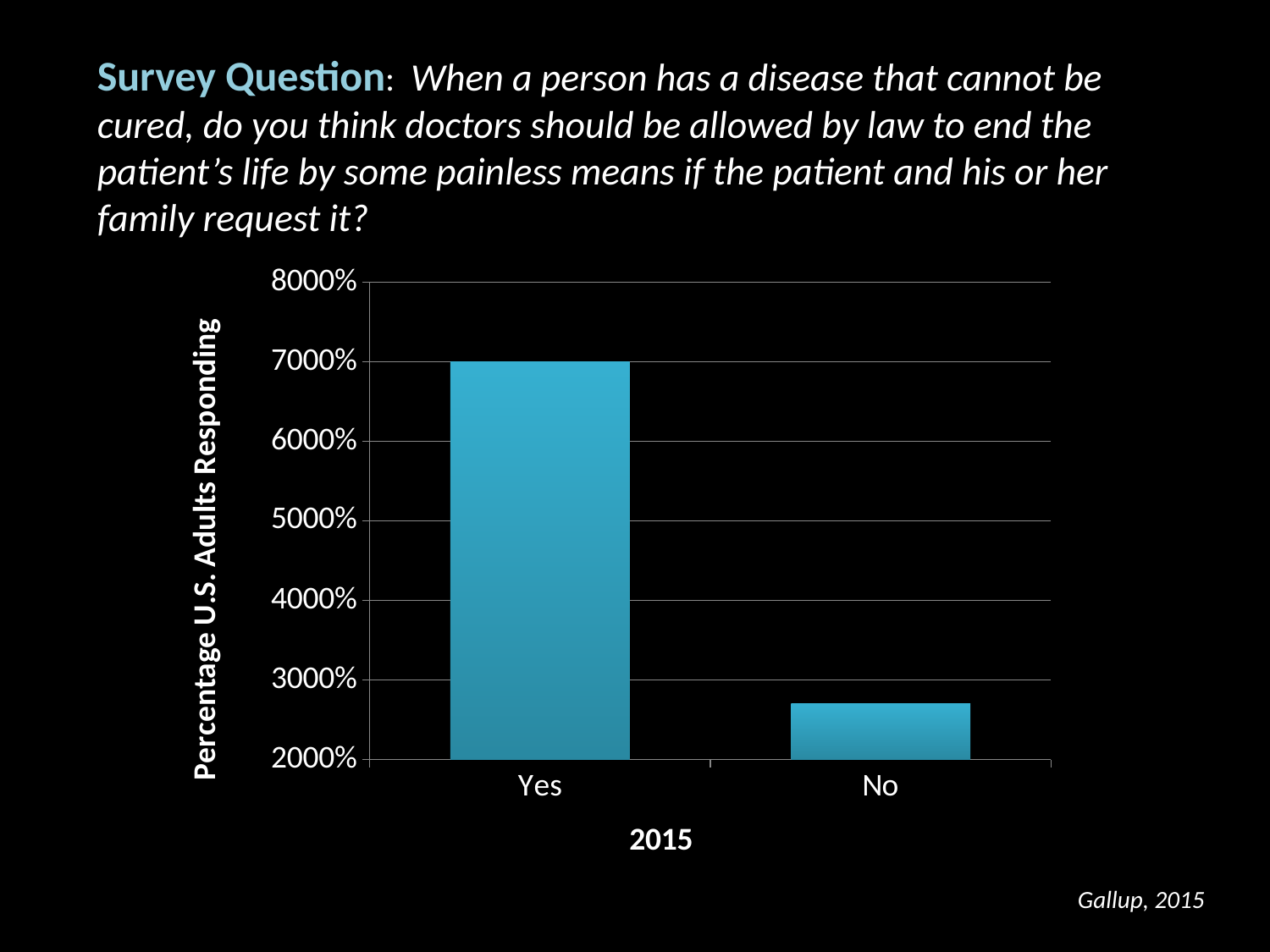
Is the value for No greater or less than 2000%? greater Is the value for No greater or less than 3000%? less What is the title of the y axis? Percentage U.S. Adults Responding What kind of chart is shown on the slide? bar chart How many categories are plotted on the x axis? 2 Is the value for Yes greater or less than 6000%? greater Which category has the lowest bar? No Do the bar values rise or fall moving from Yes to No along the x axis? fall Which category has the highest bar? Yes What is the title of the x axis? 2015 Which is larger, the value for Yes or the value for No? Yes What value does the Yes bar reach on the y axis? 7000%